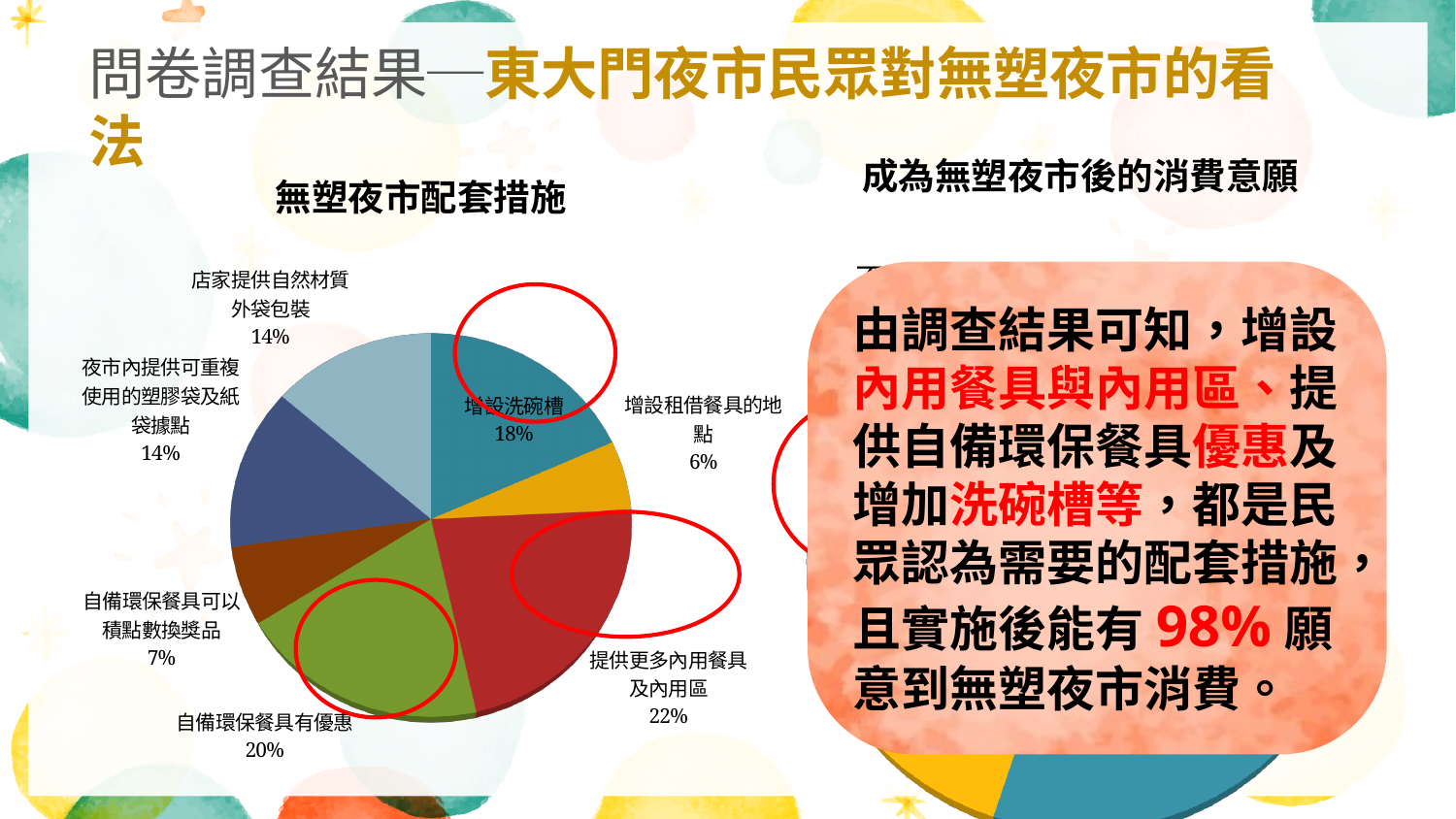
In the 無塑夜市配套措施 pie chart, what percentage is shown for 提供更多內用餐具及內用區? 22% In the 無塑夜市配套措施 pie chart, what percentage is shown for 增設租借餐具的地點? 6% In the 無塑夜市配套措施 pie chart, which category has the smallest share? 增設租借餐具的地點 What kind of chart is the 無塑夜市配套措施 chart on the left of the slide? Pie chart What is the title of the chart on the right side of the slide? 成為無塑夜市後的消費意願 How many categories are shown in the 無塑夜市配套措施 pie chart? 7 In the 無塑夜市配套措施 pie chart, what is the difference in percentage points between 提供更多內用餐具及內用區 and 增設洗碗槽? 4 In the 無塑夜市配套措施 pie chart, what percentage is shown for 自備環保餐具可以積點數換獎品? 7% In the 無塑夜市配套措施 pie chart, which category has the largest share? 提供更多內用餐具及內用區 In the 無塑夜市配套措施 pie chart, which is larger: 自備環保餐具有優惠 or 店家提供自然材質外袋包裝? 自備環保餐具有優惠 In the 無塑夜市配套措施 pie chart, what percentage is shown for 自備環保餐具有優惠? 20% In the 無塑夜市配套措施 pie chart, what percentage is shown for 增設洗碗槽? 18%